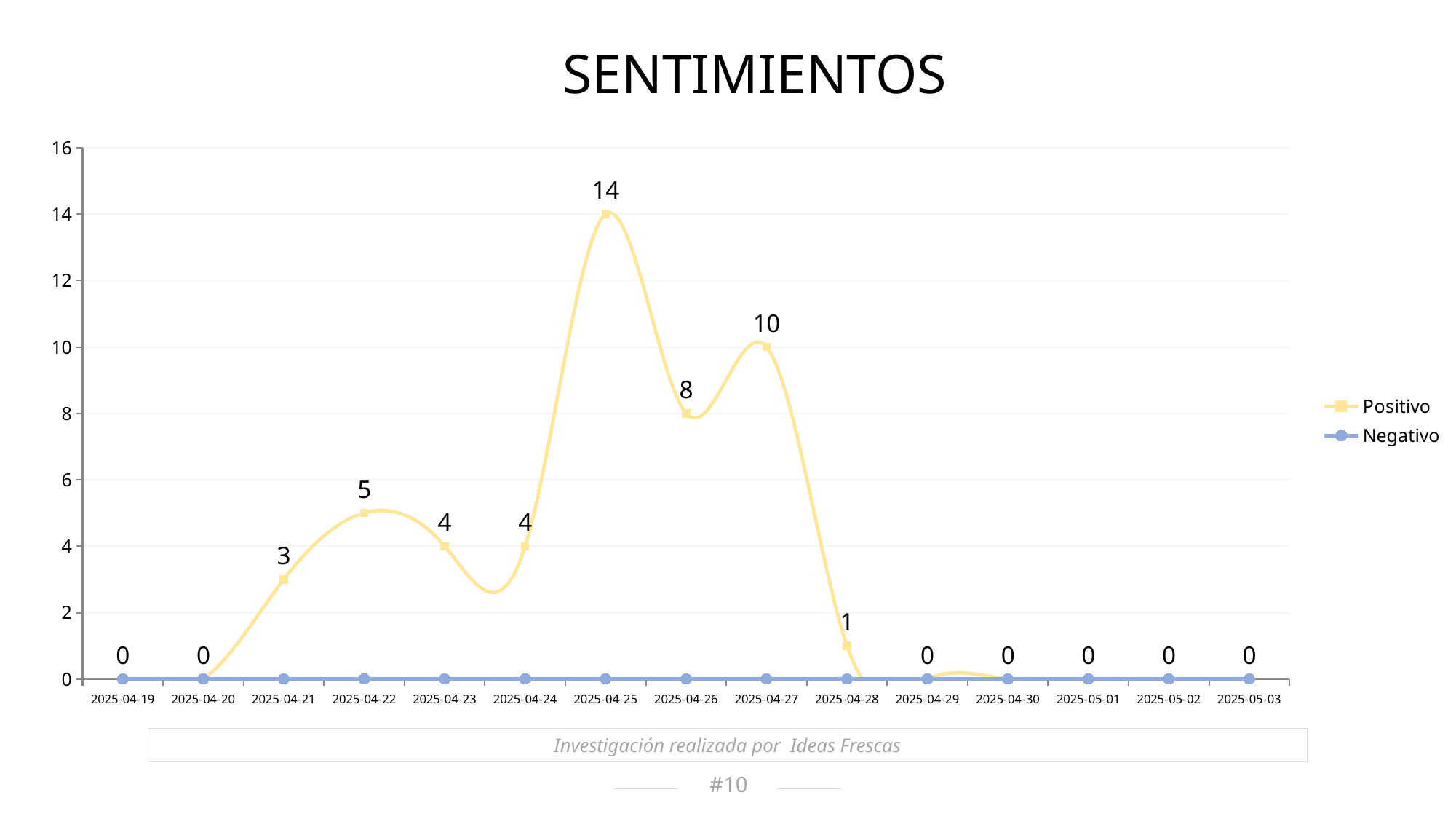
What type of chart is shown on the slide? line chart What is the Positivo value on 2025-04-22? 5 What is the Positivo value on 2025-04-28? 1 What is the difference between the Positivo values on 2025-04-25 and 2025-04-27? 4 What is the title of the chart? SENTIMIENTOS Which is larger, the Positivo value on 2025-04-26 or on 2025-04-27? 2025-04-27 What is the Positivo value on 2025-04-25? 14 How many dates are shown on the x axis? 15 Does the Positivo series rise or fall from 2025-04-27 to 2025-04-28? fall Which legend entry is drawn in blue? Negativo How many series does the legend list? 2 On which date does the Positivo series reach its highest value? 2025-04-25